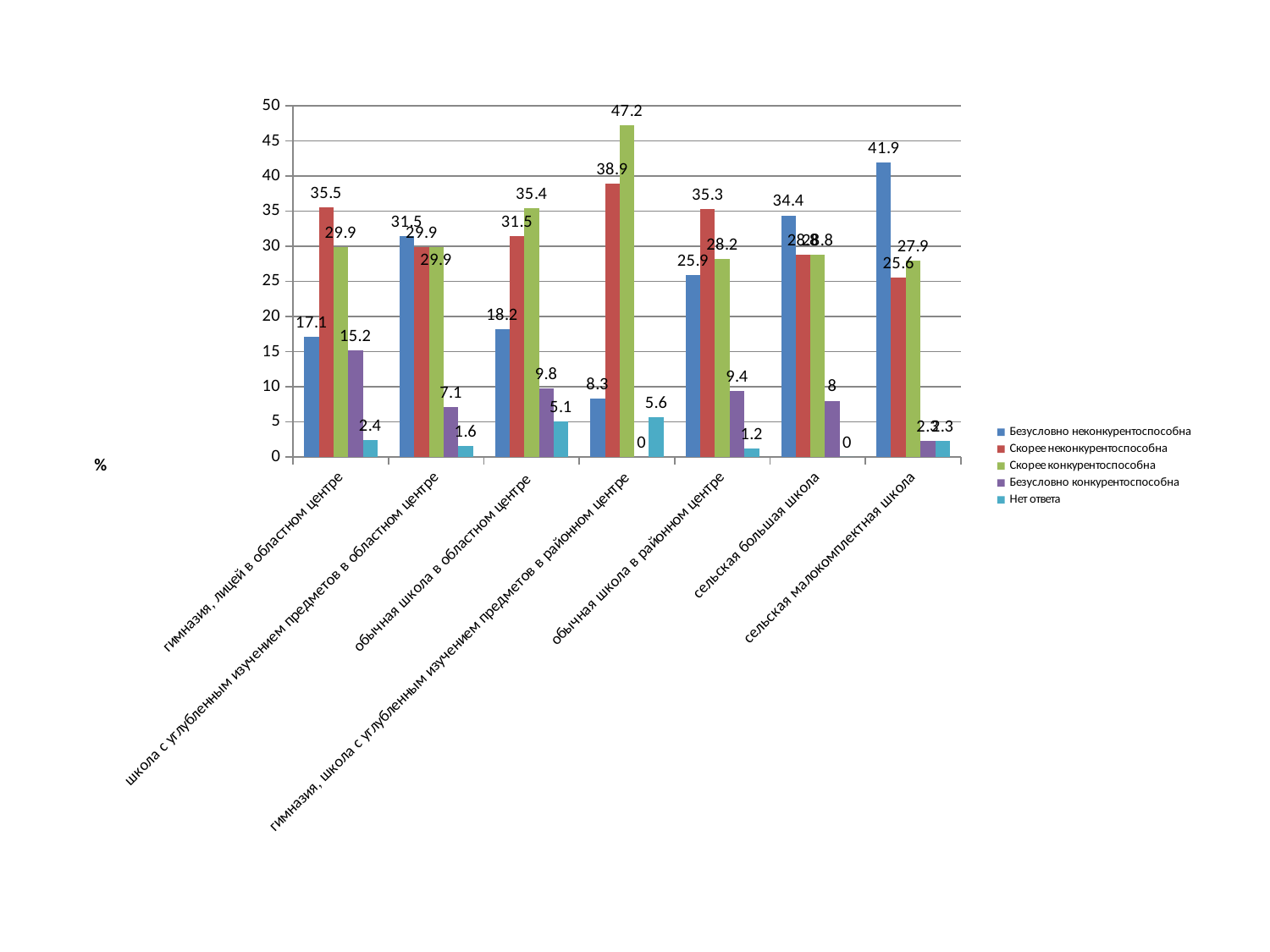
For "обычная школа в областном центре", which is larger: "Скорее конкурентоспособна" or "Скорее неконкурентоспособна"? Скорее конкурентоспособна What is the difference between "Скорее неконкурентоспособна" and "Безусловно неконкурентоспособна" for "гимназия, лицей в областном центре"? 18.4 How many series does the legend list? 5 Which school category has the lowest value for "Безусловно неконкурентоспособна"? гимназия, школа с углубленным изучением предметов в районном центре How many school categories are shown on the x axis? 7 Which school category has the highest value for "Безусловно неконкурентоспособна"? сельская малокомплектная школа What unit label is shown next to the vertical axis? % What is the value of "Нет ответа" for "сельская большая школа"? 0 What type of chart is shown on the slide? bar chart What is the value of "Безусловно неконкурентоспособна" for "сельская малокомплектная школа"? 41.9 What is the value of "Безусловно конкурентоспособна" for "гимназия, лицей в областном центре"? 15.2 What is the value of "Скорее конкурентоспособна" for "гимназия, школа с углубленным изучением предметов в районном центре"? 47.2